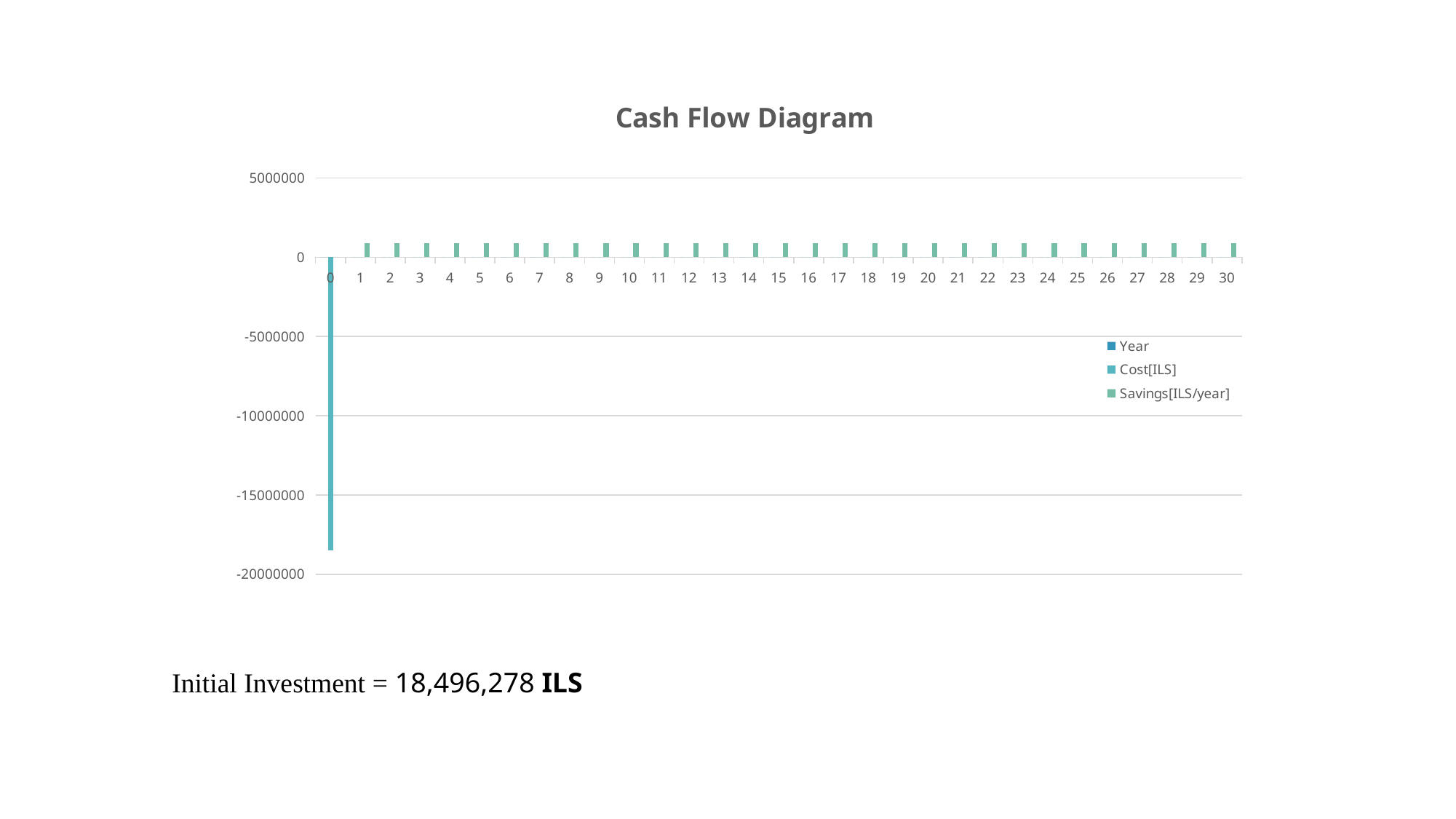
Is the value for Savings[ILS/year] at year 1 greater or less than 5000000? less What is the third entry in the chart legend? Savings[ILS/year] What kind of chart is shown on the slide? bar chart Which is larger, the value at year 0 or the value at year 10? year 10 Which year has the lowest value on the chart? 0 What is the title of the chart? Cash Flow Diagram How many series does the legend list? 3 Is the value for Savings[ILS/year] at year 15 greater or less than 0? greater How many year categories are shown on the x axis? 31 Is the value for Cost[ILS] at year 0 greater or less than -15000000? less Do the Savings[ILS/year] bars rise, fall, or stay level from year 1 to year 30? stay level